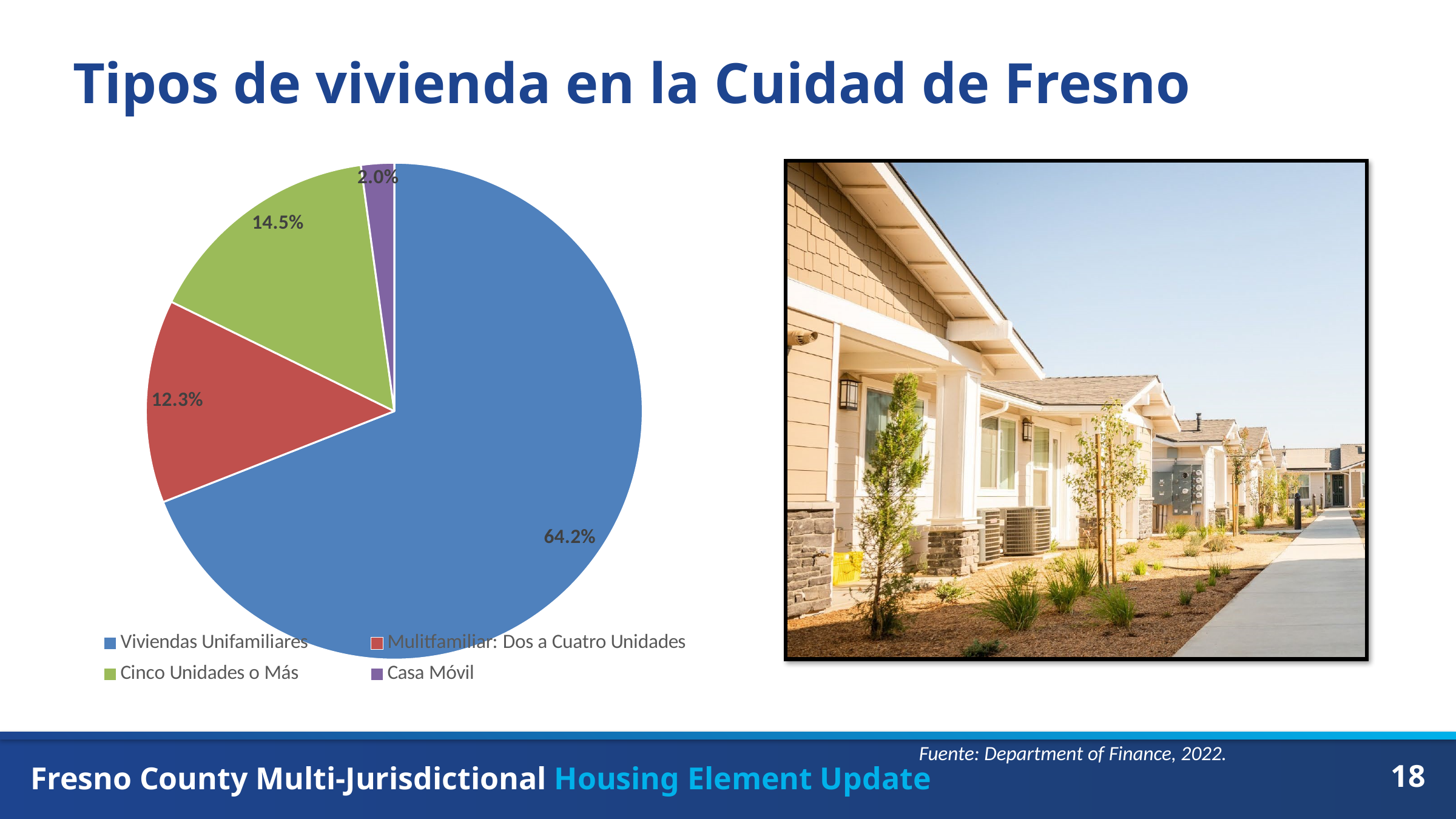
What share of the pie is Cinco Unidades o Más? 14.5% What type of chart is shown on the slide? Pie chart What colour is the slice for Casa Móvil? Purple What is the difference in percentage points between Cinco Unidades o Más and Mulitfamiliar: Dos a Cuatro Unidades? 2.2 What is the difference in percentage points between Viviendas Unifamiliares and Cinco Unidades o Más? 49.7 What share of the pie is Mulitfamiliar: Dos a Cuatro Unidades? 12.3% How many categories does the pie chart have? 4 What share of the pie is Casa Móvil? 2.0% Which category has the largest slice of the pie? Viviendas Unifamiliares Which category has the smallest slice of the pie? Casa Móvil Which is larger: Cinco Unidades o Más or Mulitfamiliar: Dos a Cuatro Unidades? Cinco Unidades o Más